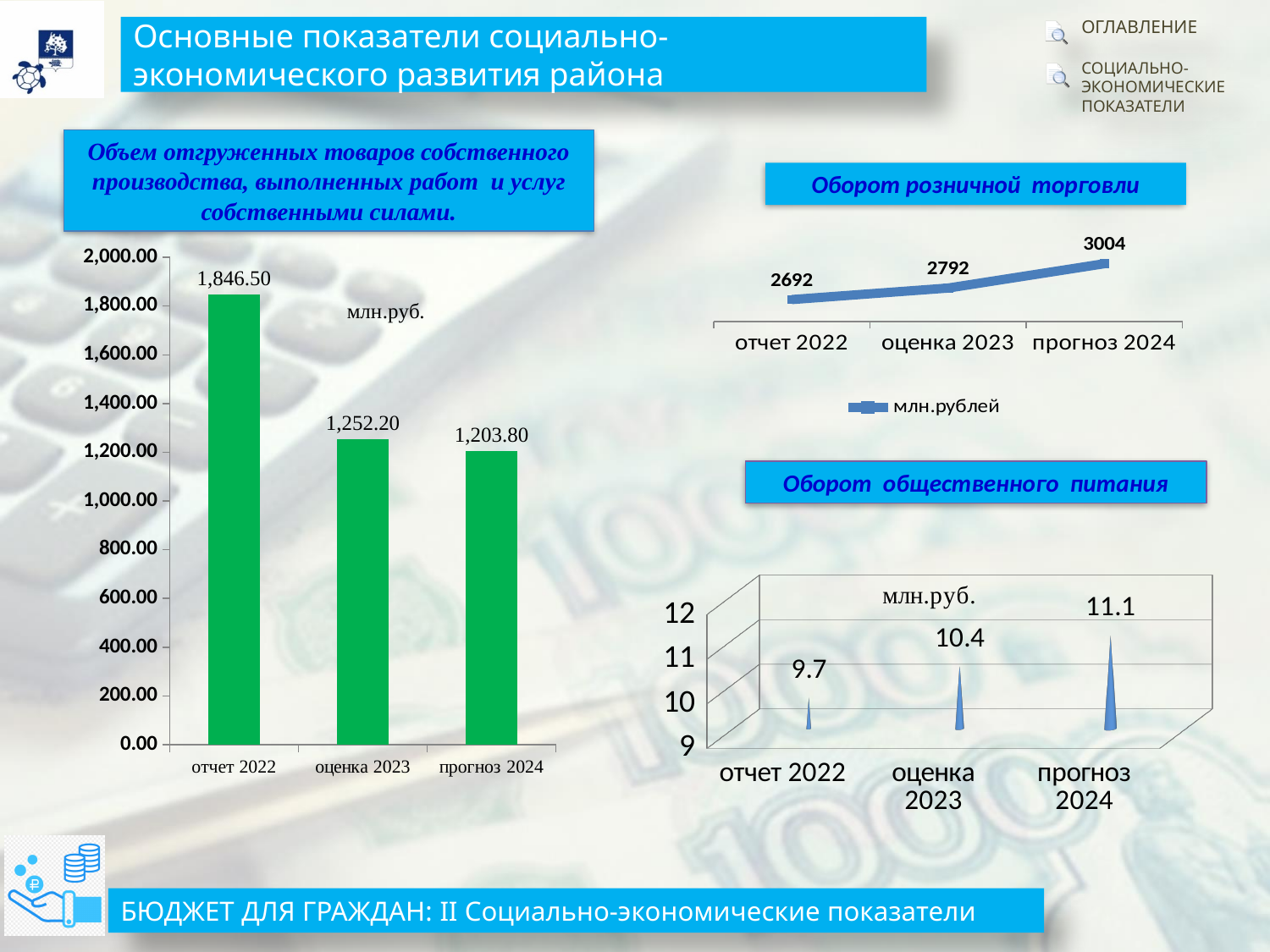
On the chart 'Оборот розничной торговли', which category has the highest value? прогноз 2024 On the chart 'Объем отгруженных товаров собственного производства, выполненных работ и услуг собственными силами', which category has the lowest value? прогноз 2024 On the chart 'Объем отгруженных товаров собственного производства, выполненных работ и услуг собственными силами', what is the difference between отчет 2022 and оценка 2023? 594.30 On the chart 'Объем отгруженных товаров собственного производства, выполненных работ и услуг собственными силами', what is the value for отчет 2022? 1,846.50 What kind of chart is 'Оборот розничной торговли'? line chart On the chart 'Оборот розничной торговли', what is the difference between прогноз 2024 and отчет 2022? 312 On the chart 'Оборот розничной торговли', what is the value for оценка 2023? 2792 On the chart 'Оборот общественного питания', which is larger, оценка 2023 or прогноз 2024? прогноз 2024 What kind of chart is 'Объем отгруженных товаров собственного производства, выполненных работ и услуг собственными силами'? bar chart On the chart 'Объем отгруженных товаров собственного производства, выполненных работ и услуг собственными силами', do the values rise or fall from отчет 2022 to прогноз 2024? fall On the chart 'Оборот общественного питания', what is the value for отчет 2022? 9.7 How many categories are shown on the chart 'Оборот общественного питания'? 3